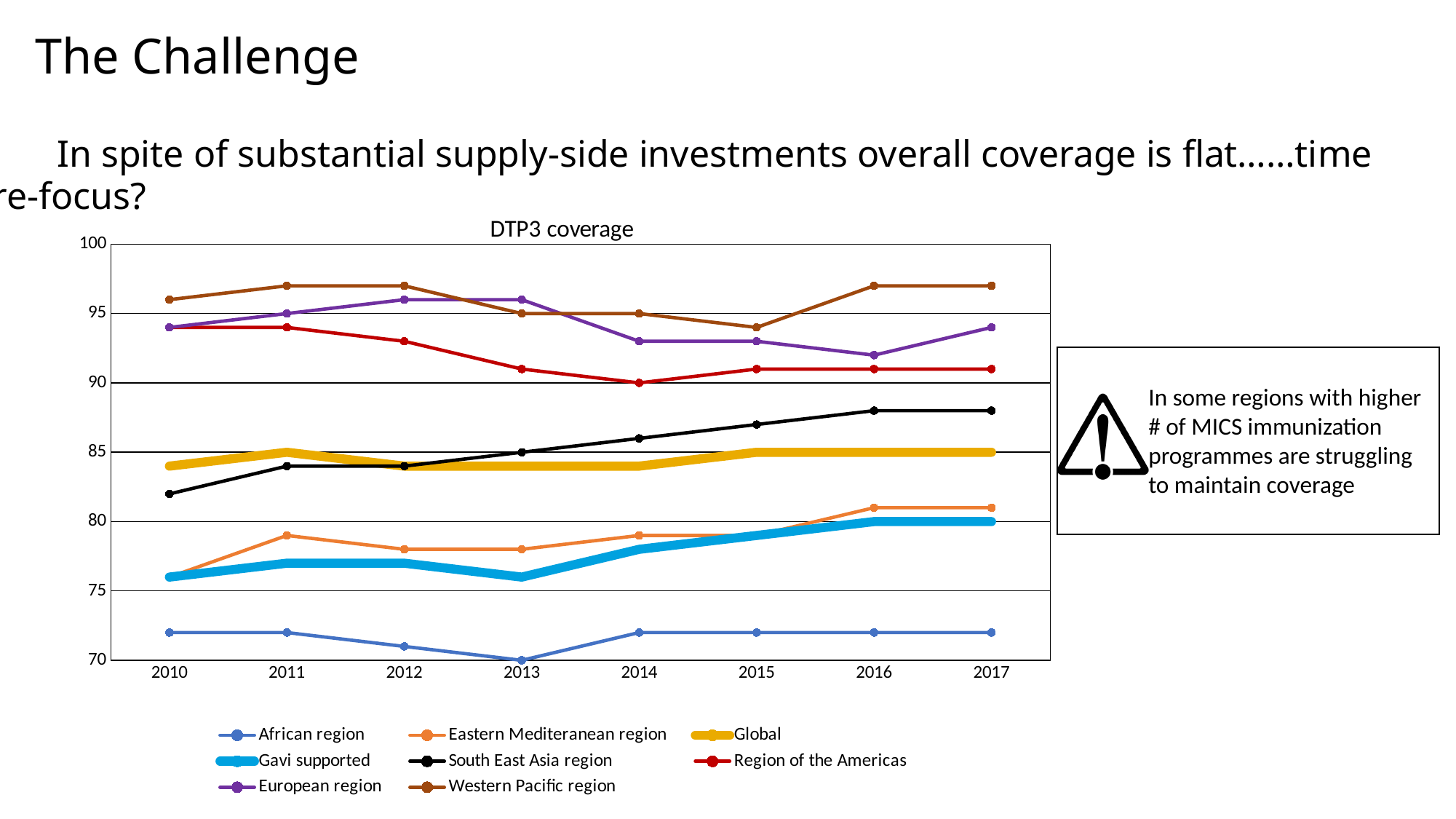
What is the value for Gavi supported in 2017? 80 What type of chart is shown on the slide? line chart How many years are shown on the x axis? 8 Which series has the lowest value in 2017? African region Does the South East Asia region line rise or fall from 2010 to 2017? rise How many series does the legend list? 8 Which series has the highest value in 2017? Western Pacific region Which is larger in 2016, the European region or the Region of the Americas? European region What is the value for the African region in 2013? 70 Is the value for the South East Asia region in 2010 greater or less than 85? less What is the value for the Region of the Americas in 2014? 90 What is the title of the chart? DTP3 coverage